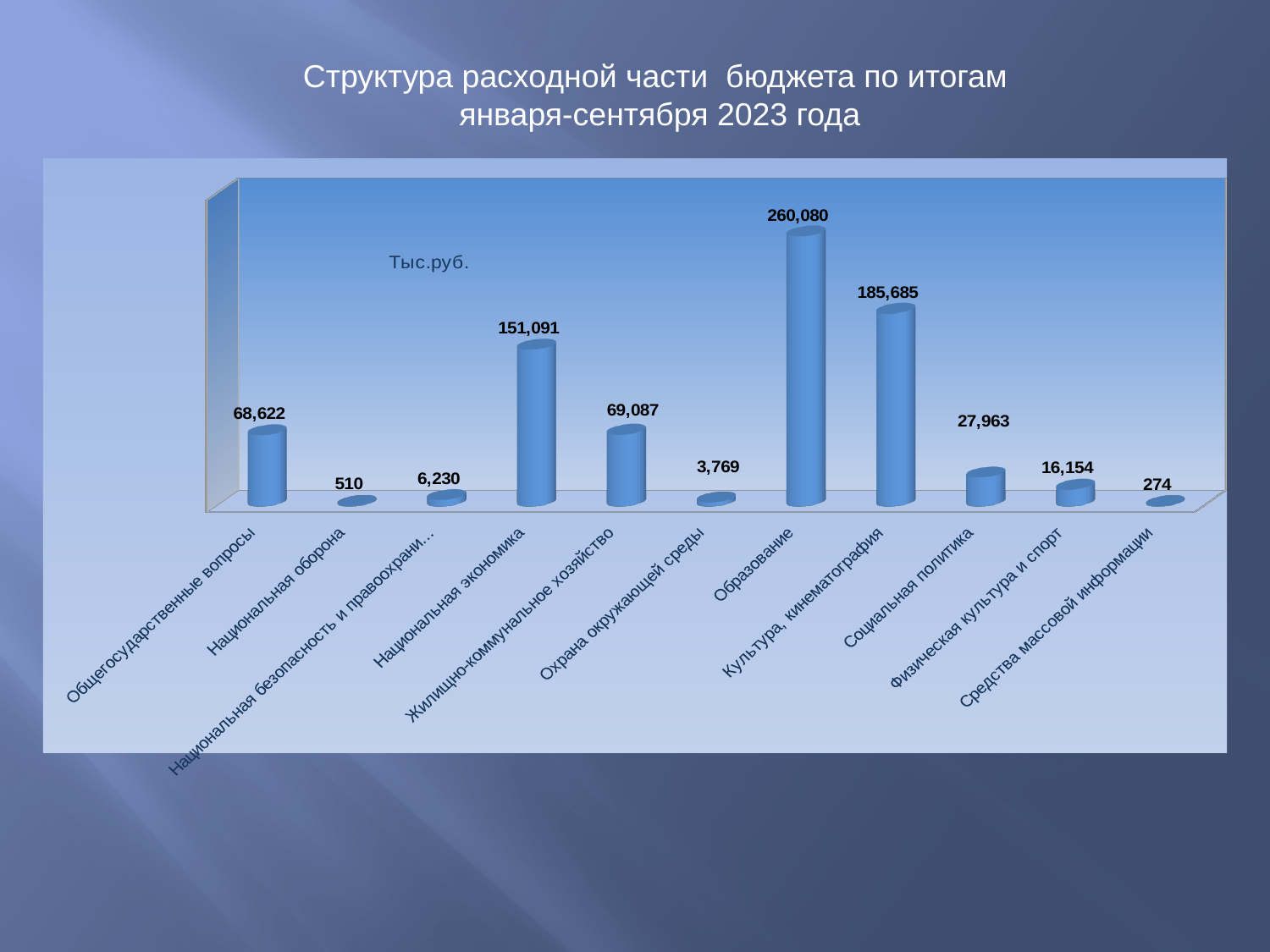
What kind of chart is shown on the slide? Bar chart What is the value for Образование? 260,080 What unit is indicated on the chart? Тыс.руб. What is the difference between the values for Образование and Культура, кинематография? 74,395 Which category has the lowest value? Средства массовой информации What is the value for Национальная экономика? 151,091 How many categories are shown on the chart? 11 What is the value for Социальная политика? 27,963 What is the value for Национальная оборона? 510 Which is larger, the value for Жилищно-коммунальное хозяйство or the value for Общегосударственные вопросы? Жилищно-коммунальное хозяйство Which category has the highest value? Образование What is the difference between the values for Социальная политика and Физическая культура и спорт? 11,809